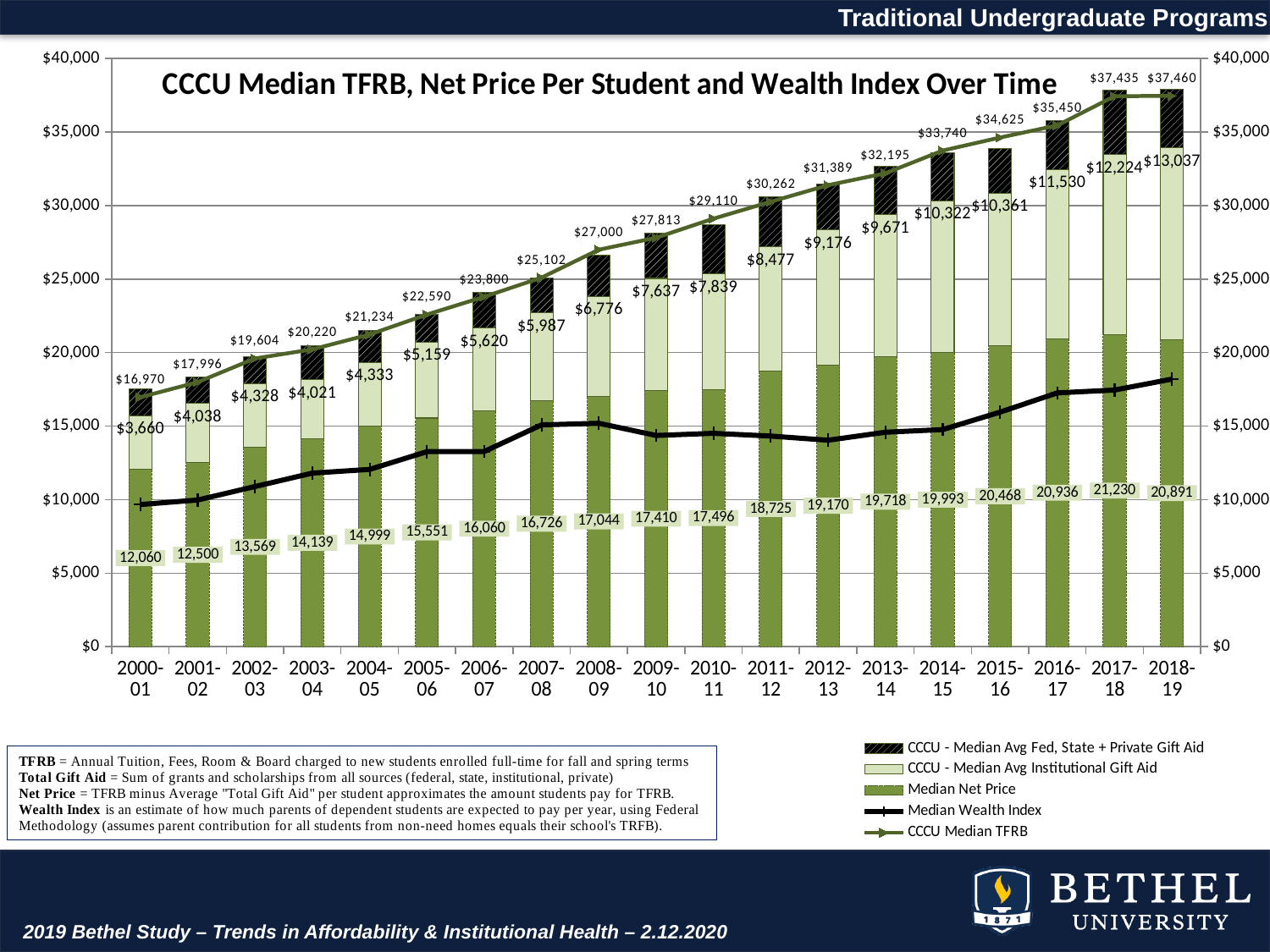
Does the CCCU Median TFRB rise or fall from 2000-01 to 2018-19? rise Is the Median Wealth Index for 2018-19 greater or less than $15,000? greater What is the difference between the CCCU Median TFRB in 2018-19 and in 2000-01? $20,490 What is the CCCU Median Avg Institutional Gift Aid value labelled for 2010-11? $7,839 How many series does the legend list? 5 What is the Median Net Price for 2000-01? 12,060 What is the CCCU Median TFRB for 2018-19? $37,460 What kind of chart is used for the gift aid and net price data? bar chart In which year is the Median Net Price highest? 2017-18 How many academic years are shown on the x axis? 19 In which year is the CCCU Median TFRB lowest? 2000-01 Which year has the larger Median Net Price, 2017-18 or 2018-19? 2017-18